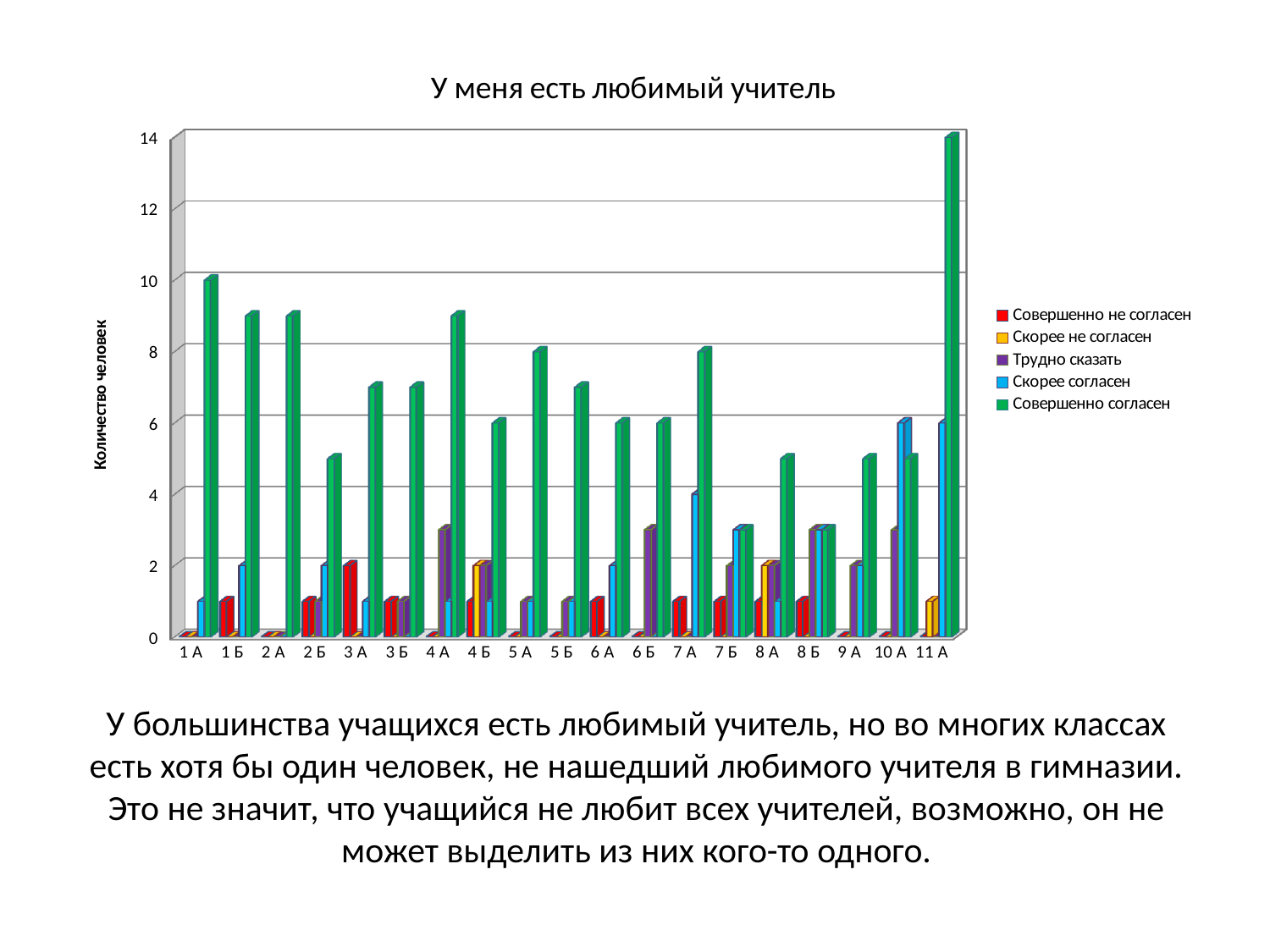
Is the value for 'Трудно сказать' in class 6 Б greater or less than 4? less How many series does the legend list? 5 Is the value for 'Скорее согласен' in class 7 А greater or less than 6? less What is the value for 'Совершенно согласен' in class 1 А? 10 Is the value for 'Совершенно согласен' in class 4 А greater or less than 8? greater What kind of chart is shown on the slide? bar chart What is the value for 'Совершенно согласен' in class 11 А? 14 What is the label of the vertical axis? Количество человек What is the title of the chart? У меня есть любимый учитель How many class categories are shown on the x axis? 19 Which class has the highest value for 'Совершенно согласен'? 11 А Which is larger: 'Совершенно согласен' for class 1 А or for class 6 А? 1 А